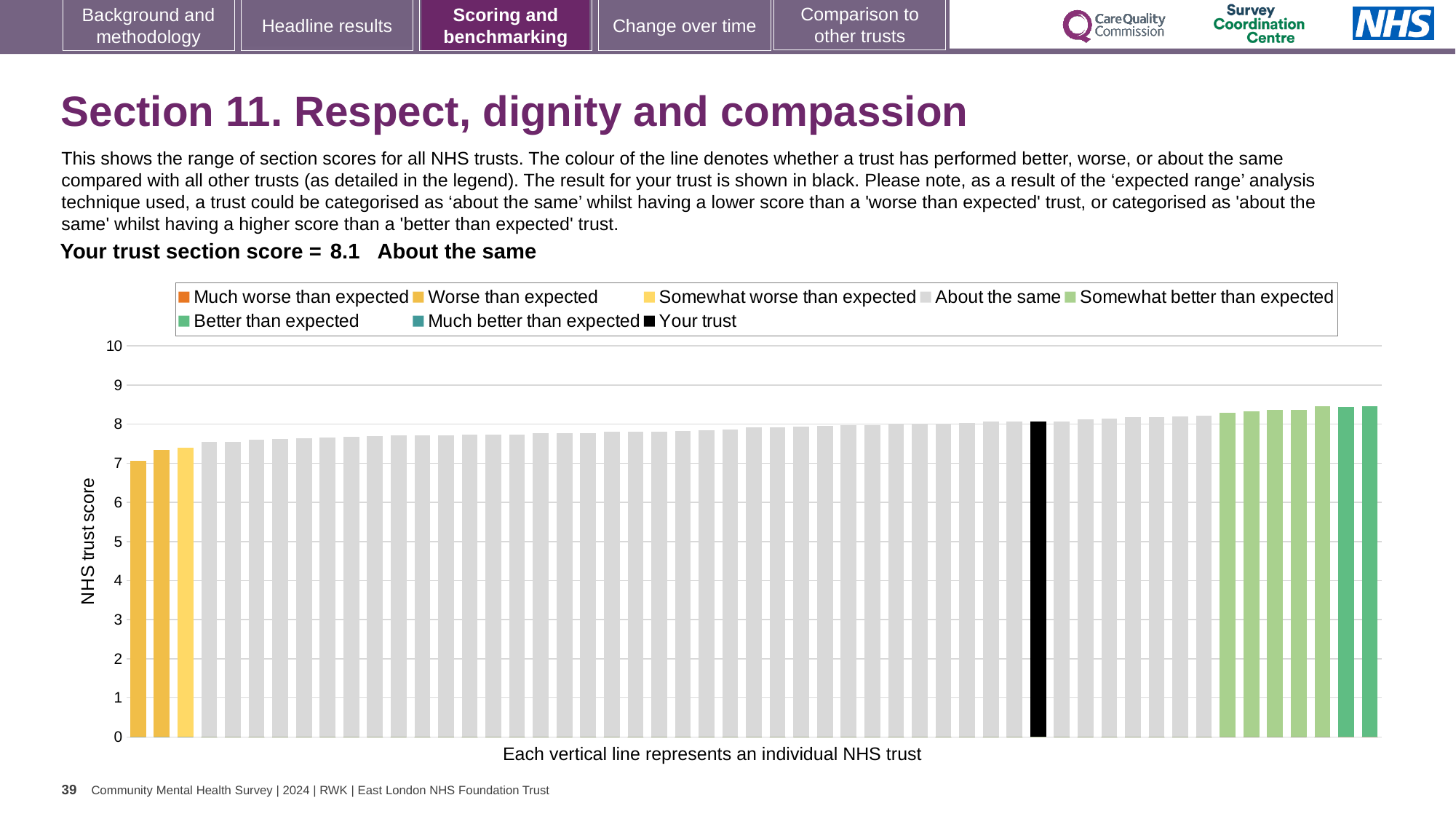
What colour is used for the bar representing your trust? black Which bar is higher: the black bar for your trust or the leftmost bar? the black bar for your trust Is the value of the rightmost bar greater or less than 9? less Is the value of the leftmost bar greater or less than 8? less What kind of chart is shown on the slide? bar chart How is your trust categorised compared with other trusts for this section? About the same Is the value for your trust (the black bar) greater or less than 7? greater How many entries does the chart legend list? 8 What is the section score for your trust shown on the slide? 8.1 What is the label on the vertical axis of the chart? NHS trust score Do the bar values rise or fall from left to right along the x axis? rise